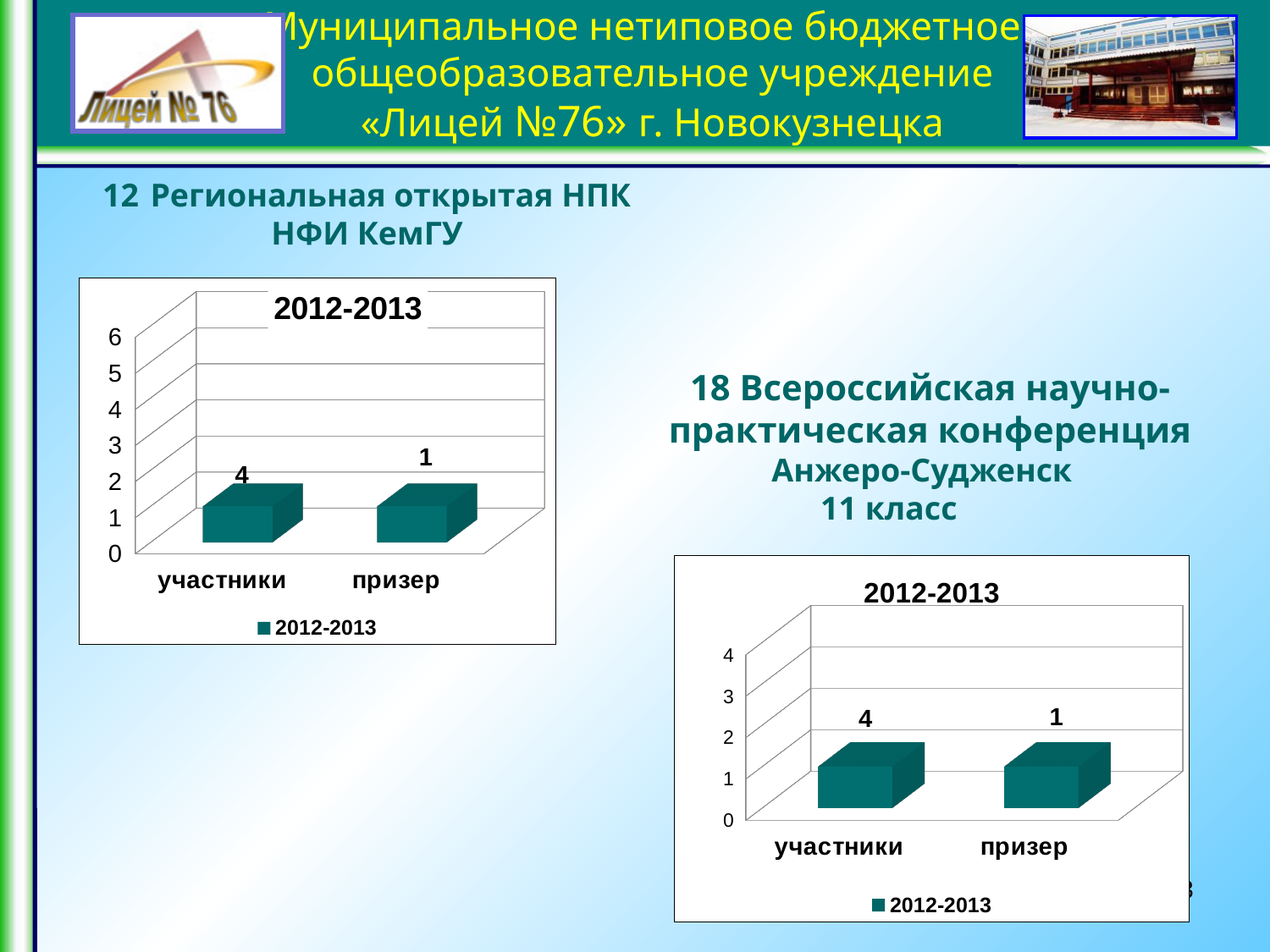
In the right chart (under '18 Всероссийская научно-практическая конференция'), what is the value for призер? 1 In the right chart (under '18 Всероссийская научно-практическая конференция'), what is the value for участники? 4 What is the legend entry in the right chart? 2012-2013 What kind of chart is the right chart? bar chart In the right chart, what is the difference between the values for участники and призер? 3 In the left chart (under '12 Региональная открытая НПК НФИ КемГУ'), what is the value for призер? 1 In the left chart, what is the highest value shown on the vertical axis? 6 In the right chart, how many series does the legend list? 1 In the left chart (under '12 Региональная открытая НПК НФИ КемГУ'), what is the value for участники? 4 In the left chart, how many categories are shown on the x axis? 2 What is the title of the left chart? 2012-2013 In the left chart, what is the difference between the values for участники and призер? 3